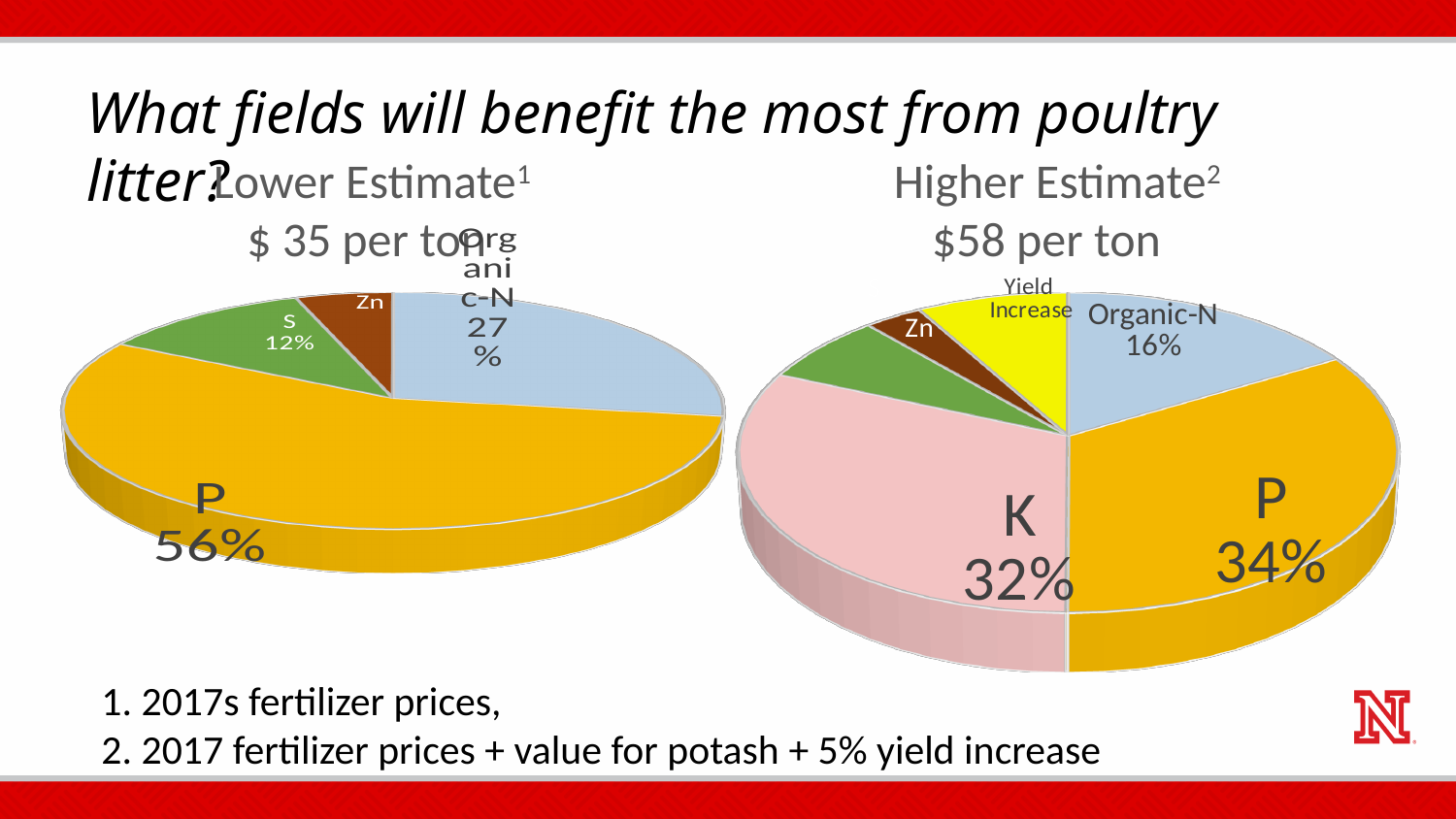
In the Higher Estimate pie chart, what share does P have? 34% In the Lower Estimate pie chart, what share does P have? 56% In the Higher Estimate pie chart, what share does Organic-N have? 16% What type of chart is used on this slide? Pie chart In the Higher Estimate pie chart, what share does K have? 32% In the Lower Estimate pie chart, which slice is the smallest? Zn What price per ton is shown for the Higher Estimate chart? $58 per ton In the Higher Estimate pie chart, which is larger, the P slice or the Organic-N slice? P In the Lower Estimate pie chart, what share does Organic-N have? 27% In the Lower Estimate pie chart, what share does S have? 12% In the Lower Estimate pie chart, what is the difference between the P share and the Organic-N share? 29 percentage points In the Lower Estimate pie chart, which slice is the largest? P